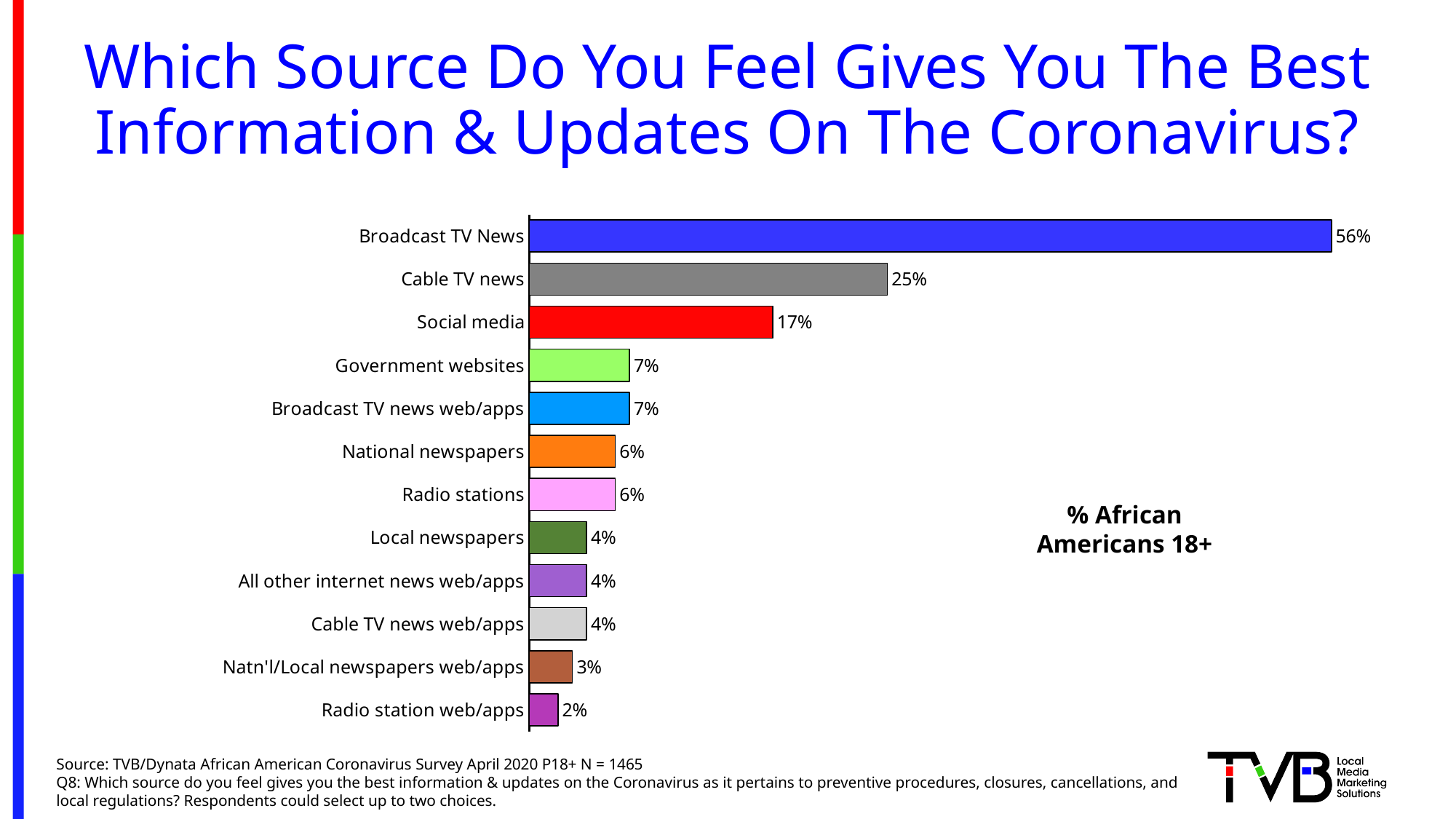
How many sources (categories) are shown on the chart? 12 Which has a higher value, National newspapers or Natn'l/Local newspapers web/apps? National newspapers What type of chart is shown on the slide? Bar chart What is the difference in percentage points between Broadcast TV News and Cable TV news? 31 What is the value shown for Cable TV news? 25% Which source has the lowest percentage on the chart? Radio station web/apps Which has a higher value, Cable TV news or Social media? Cable TV news Which source has the highest percentage on the chart? Broadcast TV News What is the difference in percentage points between Social media and Government websites? 10 What percentage of respondents chose Broadcast TV News as the source giving the best information on the Coronavirus? 56% What is the value for Radio station web/apps? 2% What percentage is shown for Social media? 17%